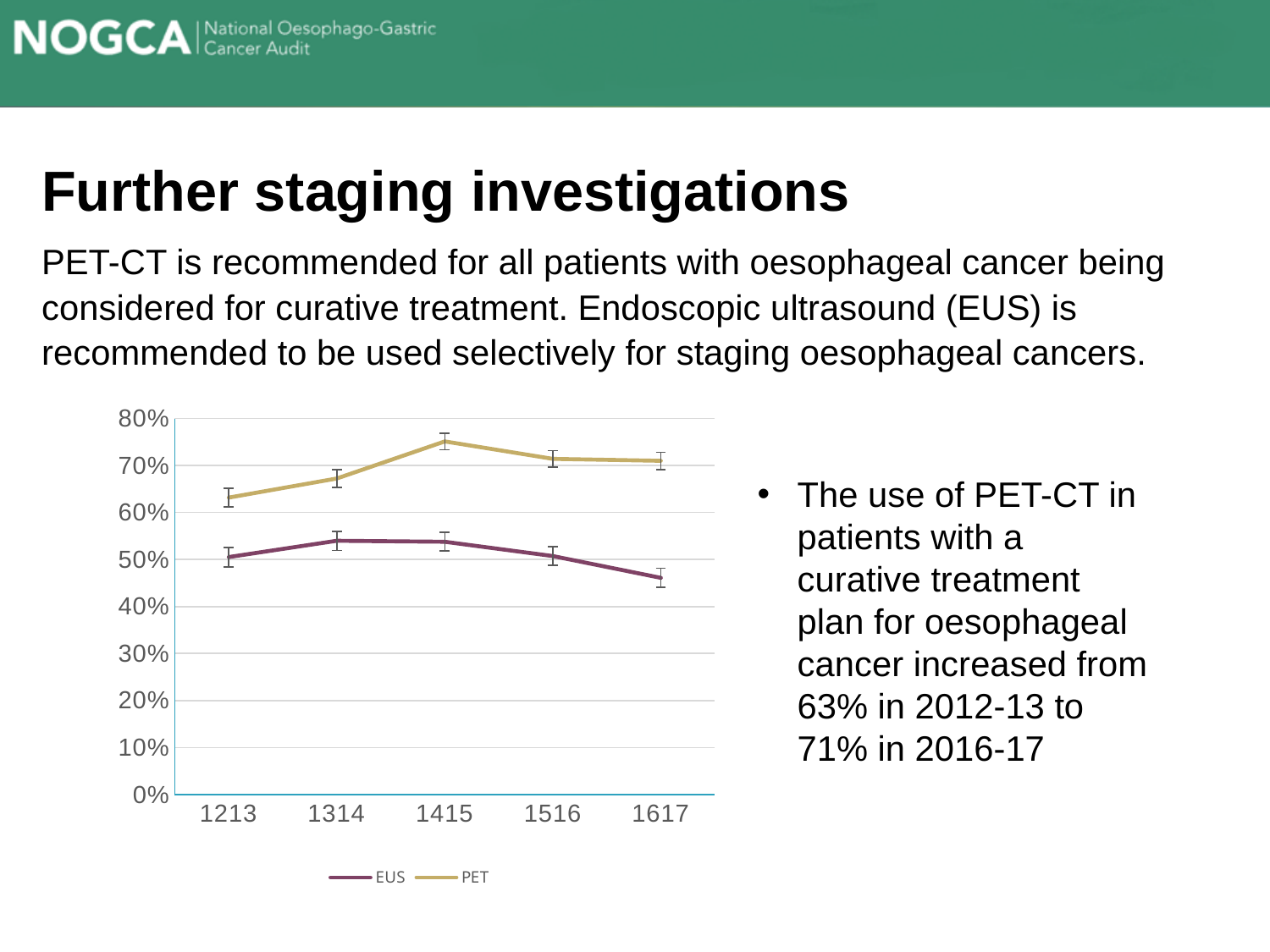
In which period does the PET line reach its highest value? 1415 Is the PET value for 1415 greater or less than 70%? greater Is the PET value for 1213 greater or less than 60%? greater Does the EUS line rise or fall between 1415 and 1617? fall Does the PET line rise or fall between 1213 and 1415? rise How many series does the chart legend list? 2 What are the two series named in the chart legend? EUS and PET Which series has the higher value in 1213, EUS or PET? PET How many time periods are plotted along the x axis of the chart? 5 In which period does the EUS line reach its lowest value? 1617 What kind of chart is shown on the slide? line chart Is the EUS value for 1617 greater or less than 50%? less